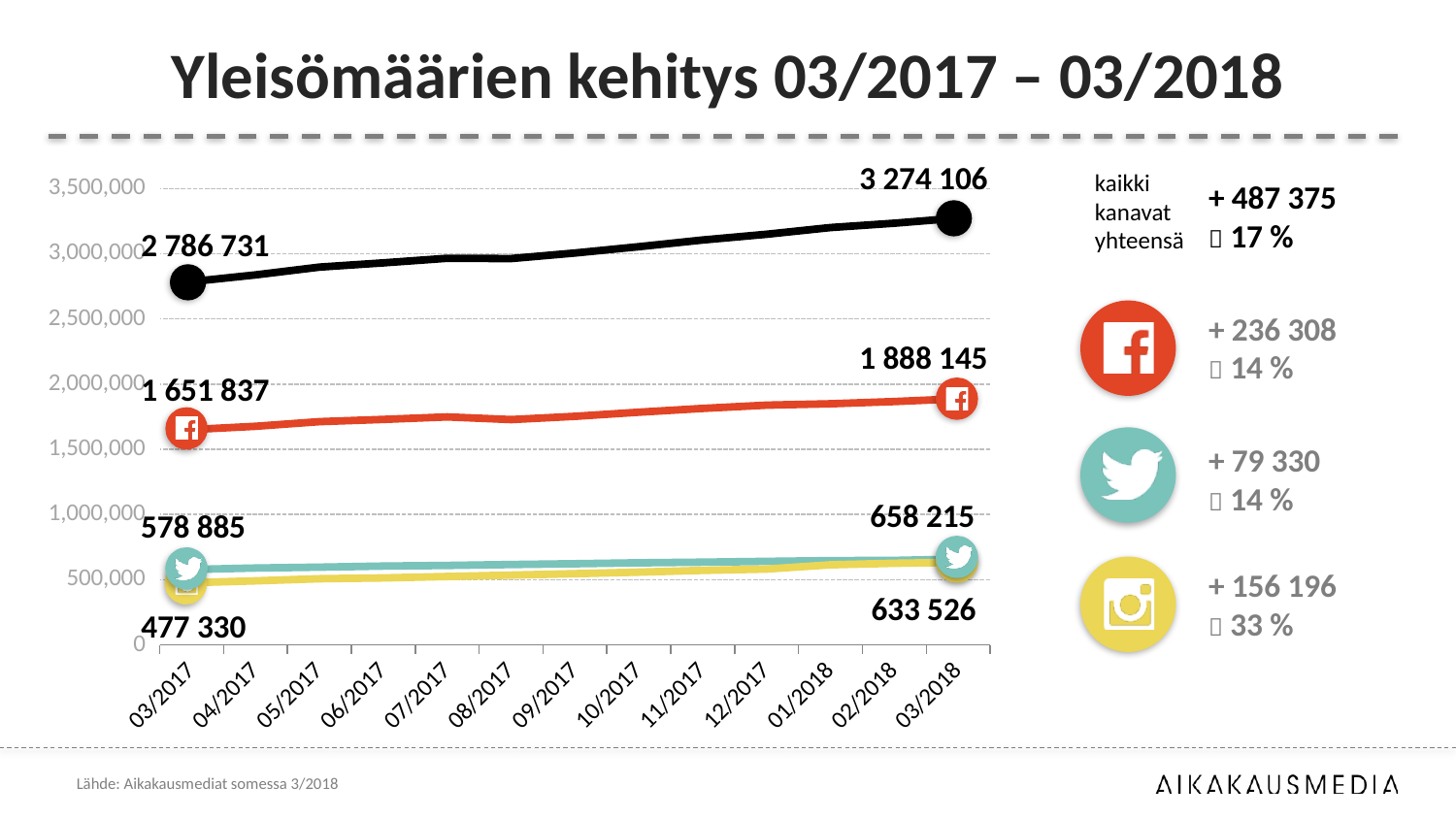
By how much did the black (top) line increase from 03/2017 to 03/2018? 487 375 What is the value of the Twitter line at 03/2017? 578 885 What is the value of the Facebook line at 03/2018? 1 888 145 What is the value of the black (top) line at 03/2017? 2 786 731 What kind of chart is shown on the slide? line chart What is the value of the Instagram (yellow) line at 03/2018? 633 526 Does the Facebook line rise or fall from 03/2017 to 03/2018? rise What is the title of the chart? Yleisömäärien kehitys 03/2017 – 03/2018 Which is larger at 03/2018, the Twitter line or the Instagram (yellow) line? Twitter line What is the value of the black (top) line at 03/2018? 3 274 106 How many time points are shown on the x axis? 13 What is the value of the Facebook line at 03/2017? 1 651 837